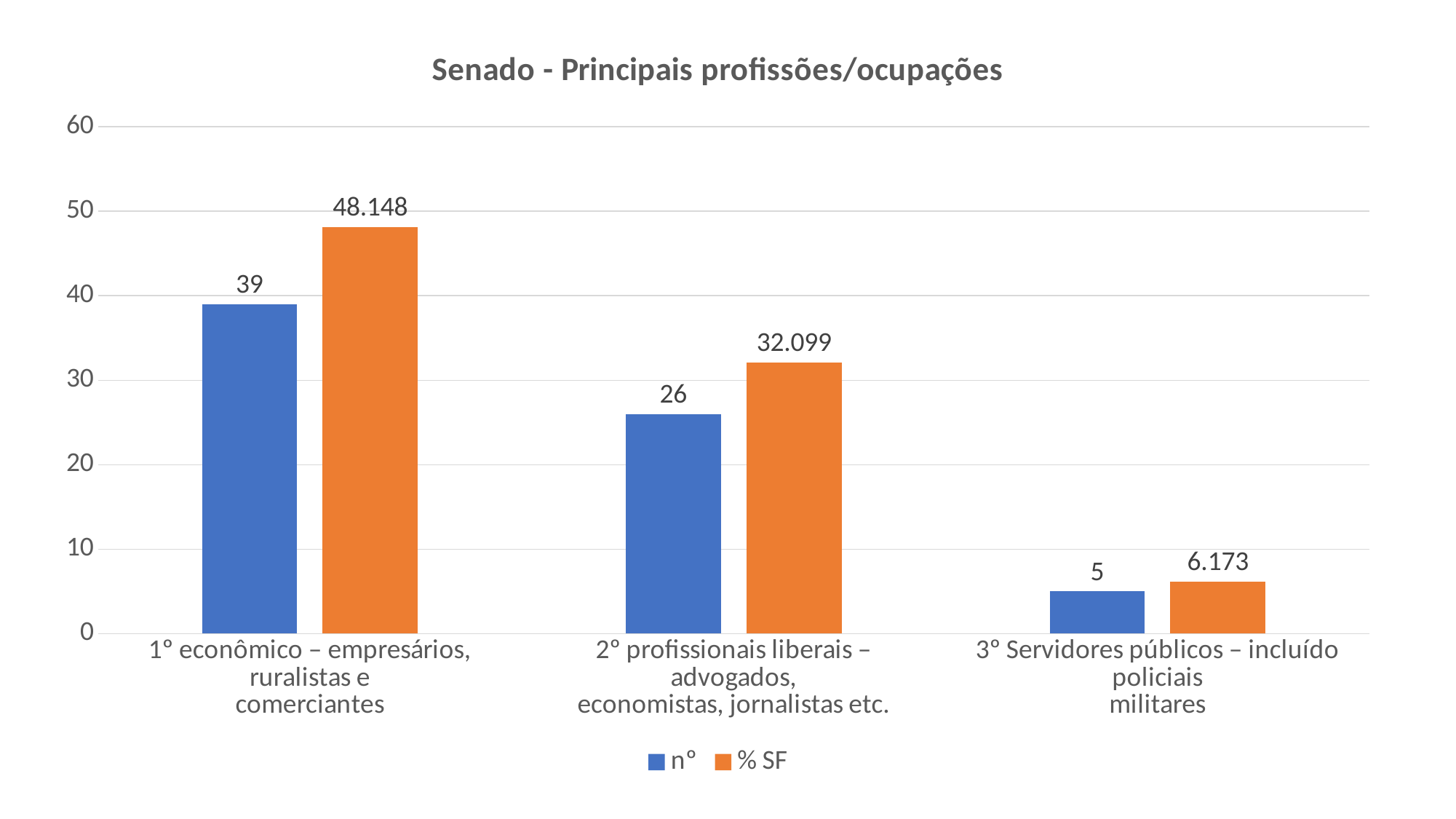
Which category has the highest n° value? 1° econômico – empresários, ruralistas e comerciantes What is the n° value for the category '3° Servidores públicos – incluído policiais militares'? 5 Which category has the lowest % SF value? 3° Servidores públicos – incluído policiais militares What is the % SF value for the category '2° profissionais liberais – advogados, economistas, jornalistas etc.'? 32.099 How many categories are shown on the x axis? 3 How many series does the legend list? 2 Which is larger: the n° value for '2° profissionais liberais' or the n° value for '3° Servidores públicos'? 2° profissionais liberais What is the n° value for the category '1° econômico – empresários, ruralistas e comerciantes'? 39 What is the difference between the n° values for '1° econômico' and '2° profissionais liberais'? 13 What is the title of the chart? Senado - Principais profissões/ocupações What kind of chart is shown on the slide? Bar chart What is the % SF value for the category '1° econômico – empresários, ruralistas e comerciantes'? 48.148